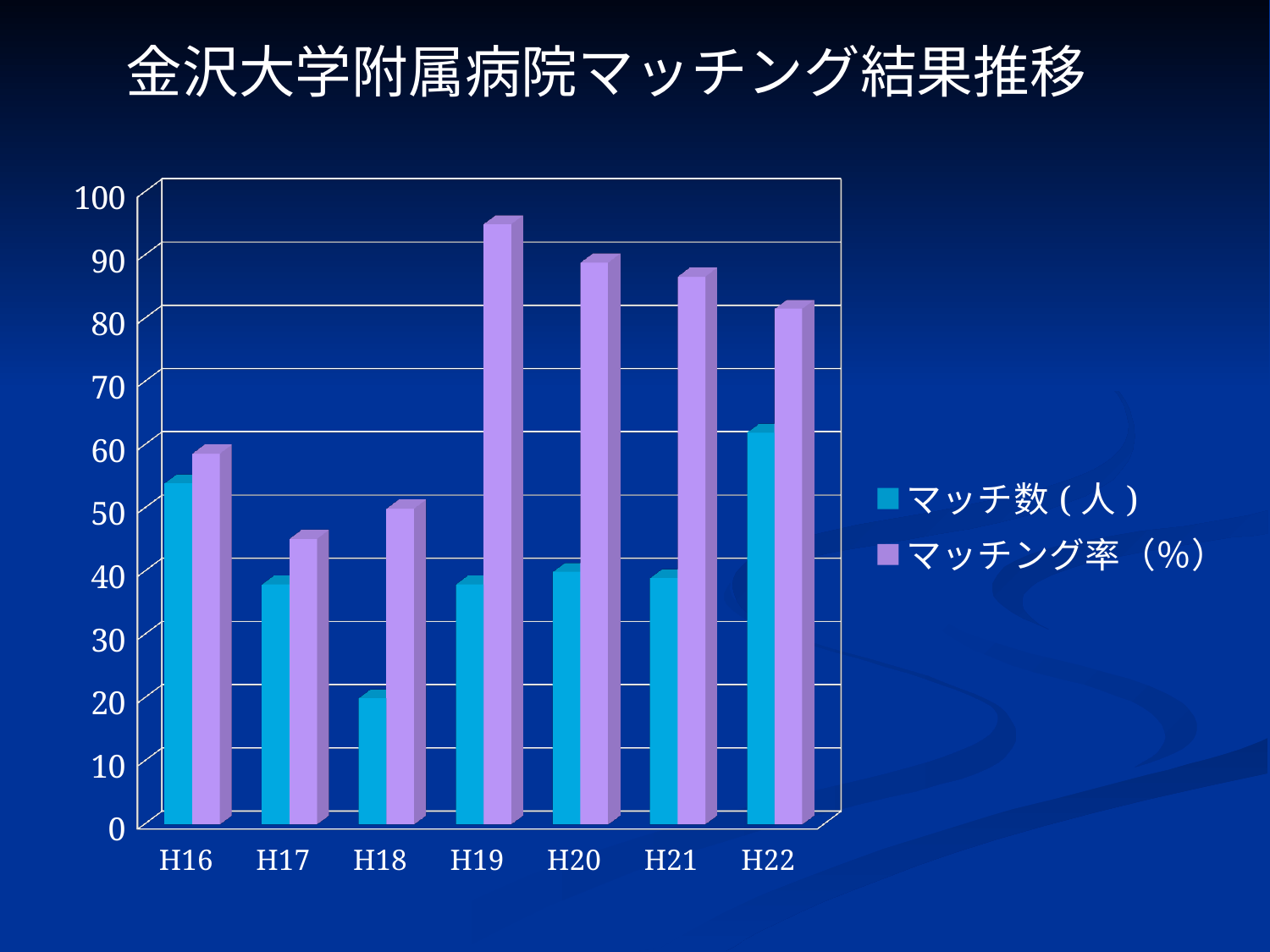
Which is larger, the マッチ数(人) for H16 or for H22? H22 Which year has the highest マッチング率（%）? H19 Is the マッチ数(人) value for H18 greater or less than 30? less Which year has the lowest マッチング率（%）? H17 What is the title of the chart on the slide? 金沢大学附属病院マッチング結果推移 Which year has the lowest マッチ数(人)? H18 How many series does the legend list? 2 How many categories (years) are shown on the x axis? 7 What kind of chart is shown on the slide? bar chart Does the マッチング率（%） rise or fall from H19 to H22? fall Is the マッチング率（%） value for H19 greater or less than 90? greater Which year has the highest マッチ数(人)? H22